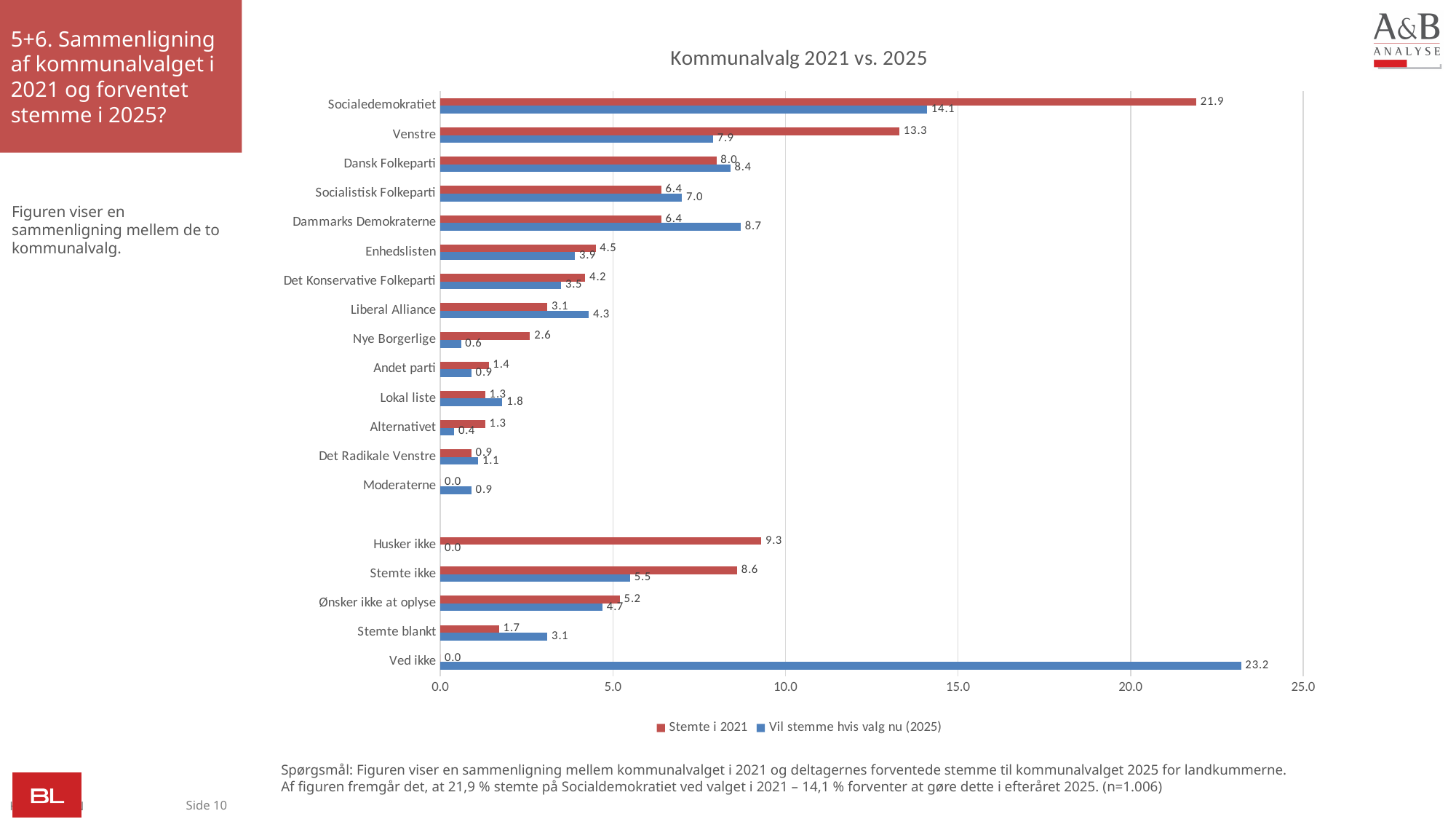
What is the difference between the "Stemte i 2021" and "Vil stemme hvis valg nu (2025)" values for Venstre? 5.4 What is the value for Ved ikke in the "Vil stemme hvis valg nu (2025)" series? 23.2 What is the value for Dammarks Demokraterne in the "Vil stemme hvis valg nu (2025)" series? 8.7 What is the title of the chart? Kommunalvalg 2021 vs. 2025 Which category has the highest value in the "Vil stemme hvis valg nu (2025)" series? Ved ikke How many series does the legend list? 2 For Liberal Alliance, which series has the larger value: "Stemte i 2021" or "Vil stemme hvis valg nu (2025)"? Vil stemme hvis valg nu (2025) Is the "Stemte i 2021" value for Husker ikke greater or less than 10.0? less Which category has the highest value in the "Stemte i 2021" series? Socialdemokratiet How many categories are shown on the y axis of the chart? 19 What kind of chart is shown on the slide? Bar chart What is the value for Socialdemokratiet in the "Stemte i 2021" series? 21.9